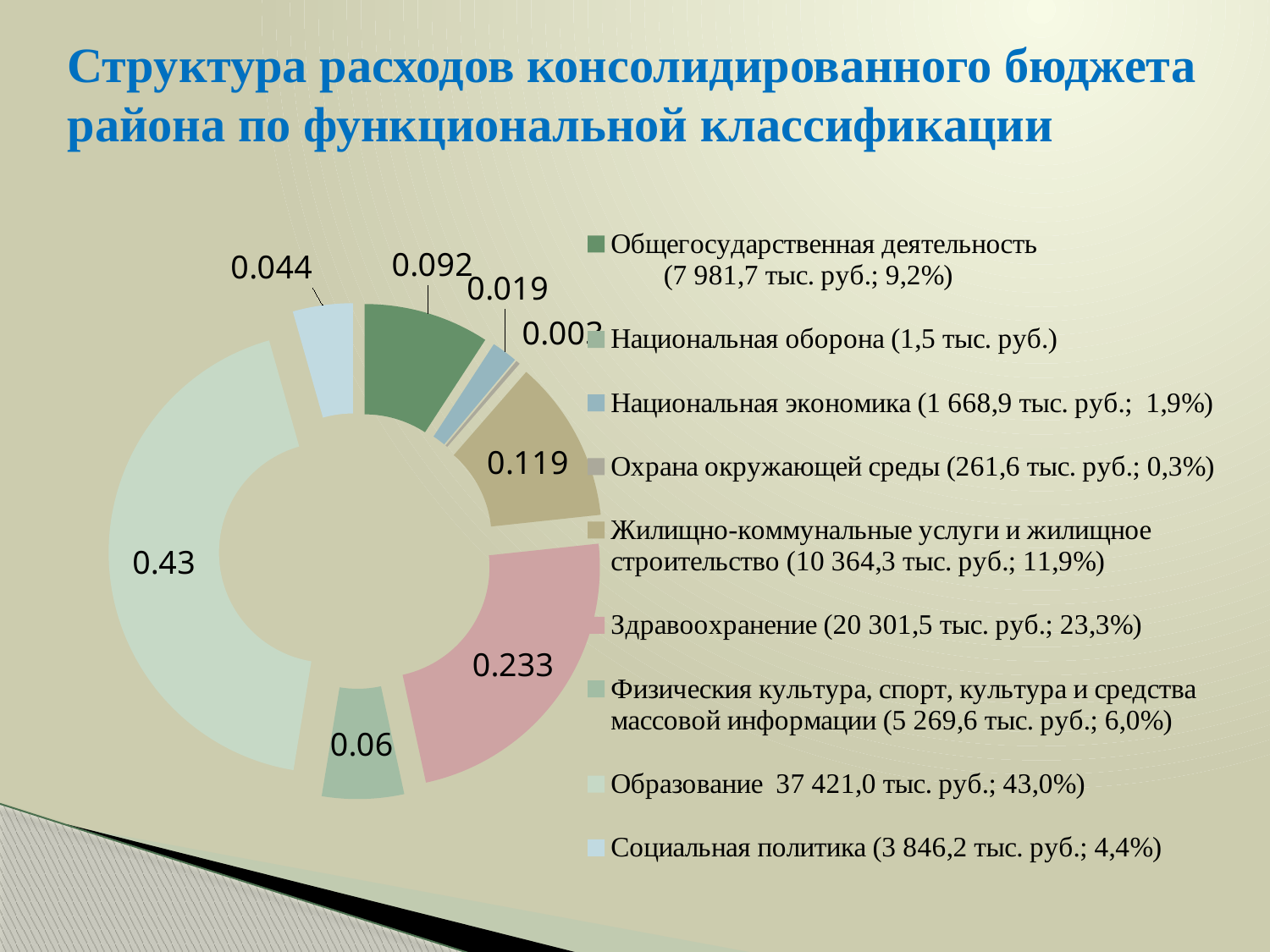
What kind of chart is shown on the slide? doughnut (pie) chart According to the legend, what is the amount for Здравоохранение? 20 301,5 тыс. руб. Which slice is larger: Жилищно-коммунальные услуги и жилищное строительство or Общегосударственная деятельность? Жилищно-коммунальные услуги и жилищное строительство What data label is shown on the slice for Образование? 0.43 What data label is shown on the slice for Социальная политика? 0.044 Which category has the largest slice in the chart? Образование What data label is shown on the slice for Здравоохранение? 0.233 What is the difference between the data labels for Здравоохранение (0.233) and Жилищно-коммунальные услуги и жилищное строительство (0.119)? 0.114 According to the legend, what share of expenditures does Образование account for? 43,0% What is the title of the slide? Структура расходов консолидированного бюджета района по функциональной классификации How many categories does the legend of the chart list? 9 Which category has the smallest slice in the chart? Охрана окружающей среды